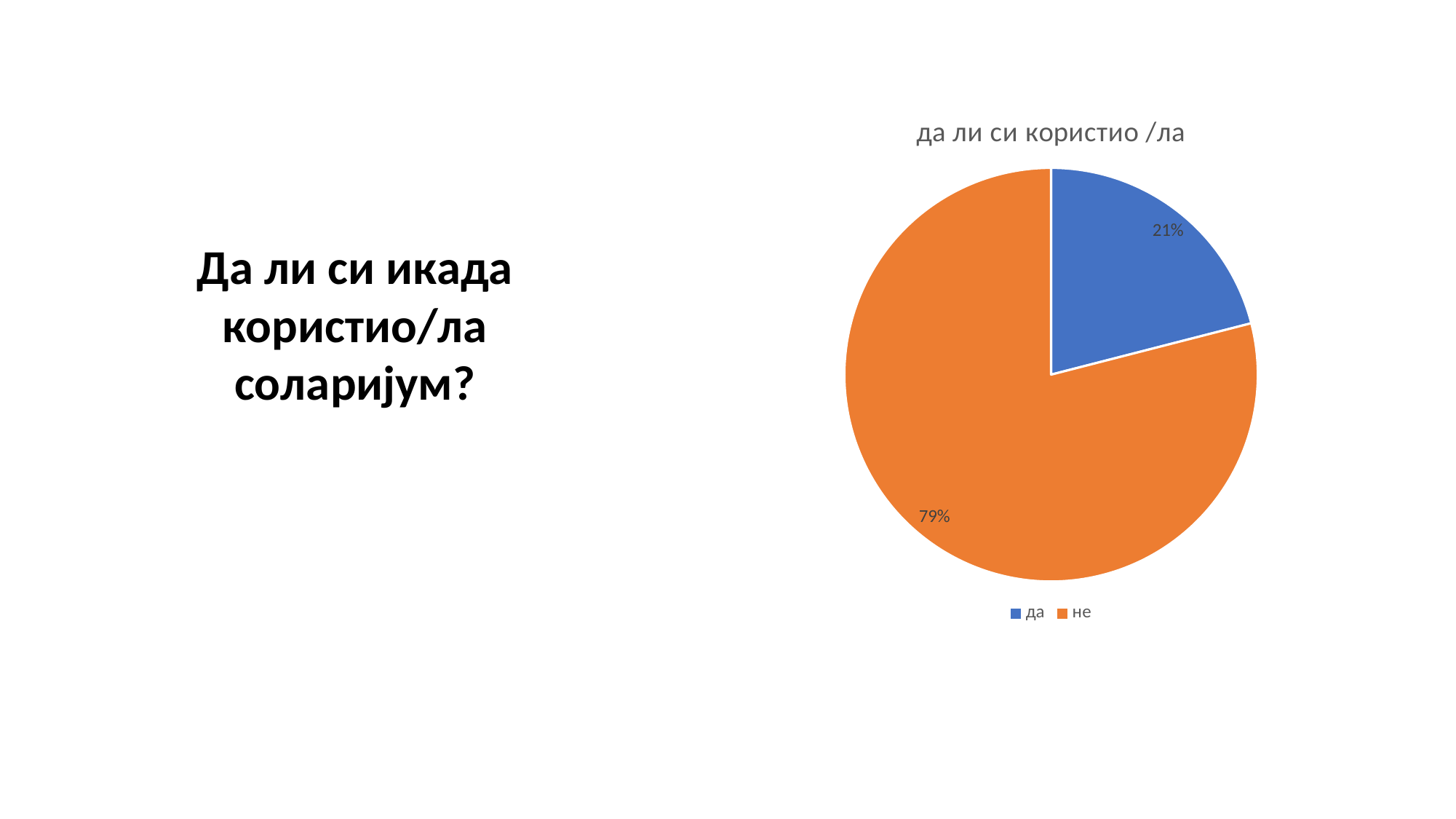
Which slice is the smallest in the pie chart? да What share of the pie does the "да" slice represent? 21% What share of the pie does the "не" slice represent? 79% What colour is the "не" slice? orange How many slices does the pie chart have? 2 How many entries does the legend list? 2 What is the difference in percentage points between the "не" and "да" slices? 58 What is the title of the chart? да ли си користио /ла Which slice is the largest in the pie chart? не Which is larger, the "да" slice or the "не" slice? не What kind of chart is shown on the slide? pie chart